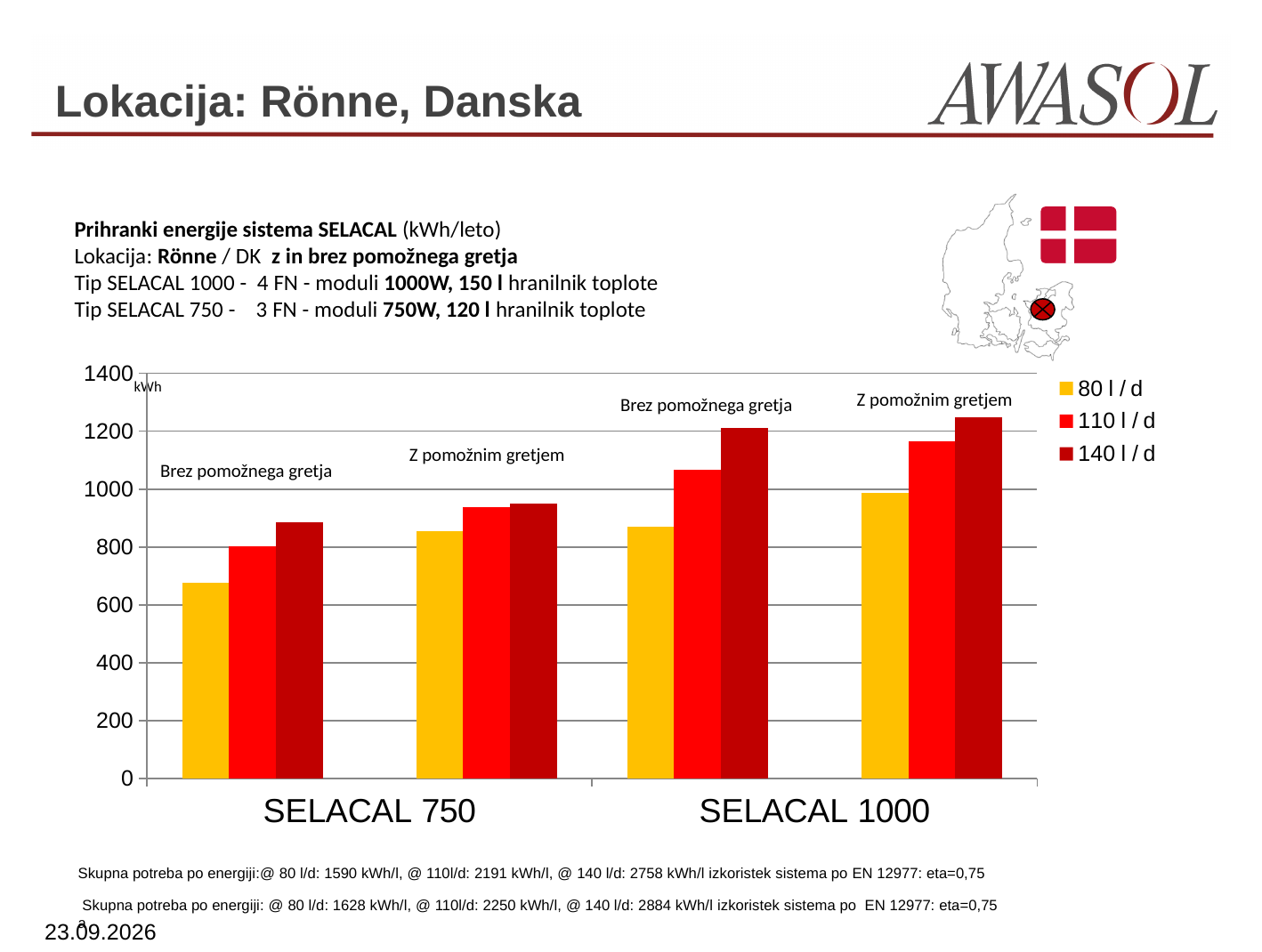
How many product categories are labelled on the x axis of the chart? 2 Which bar in the chart is the highest? 140 l / d, SELACAL 1000, Z pomožnim gretjem Which is larger: the 140 l / d bar for SELACAL 1000 without auxiliary heating (Brez pomožnega gretja) or the 140 l / d bar for SELACAL 750 with auxiliary heating (Z pomožnim gretjem)? SELACAL 1000 without auxiliary heating Which series are listed in the chart legend? 80 l / d, 110 l / d, 140 l / d What is the highest value shown on the chart's y axis? 1400 Is the 80 l / d value for SELACAL 750 without auxiliary heating (Brez pomožnega gretja) greater or less than 800? less How many series does the chart legend list? 3 Is the 110 l / d value for SELACAL 1000 without auxiliary heating (Brez pomožnega gretja) greater or less than 1000? greater Which bar in the chart is the lowest? 80 l / d, SELACAL 750, Brez pomožnega gretja Is the 140 l / d value for SELACAL 1000 with auxiliary heating (Z pomožnim gretjem) greater or less than 1200? greater Do the 140 l / d values rise or fall when moving from SELACAL 750 to SELACAL 1000? rise What kind of chart is shown on the slide? bar chart